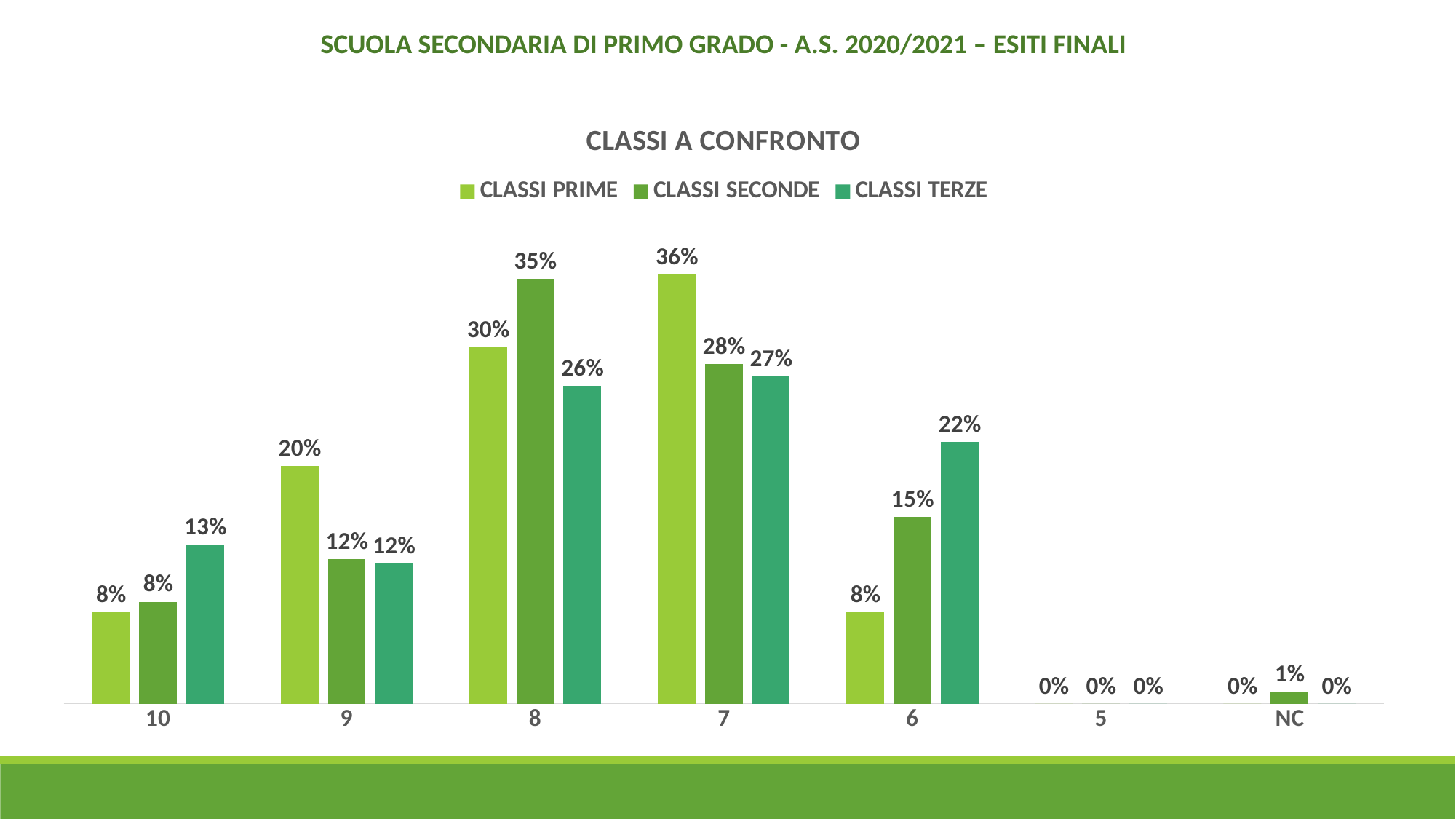
What kind of chart is shown? Bar chart What is the value for CLASSI TERZE at category 6? 22% Which is larger at category 10: CLASSI TERZE or CLASSI PRIME? CLASSI TERZE What is the value for CLASSI SECONDE at category 8? 35% What is the difference between CLASSI TERZE and CLASSI PRIME at category 6? 14% Which category has the highest value for CLASSI SECONDE? 8 What is the value for CLASSI PRIME at category 7? 36% Which category has the highest value for CLASSI PRIME? 7 What is the title of the chart? CLASSI A CONFRONTO What is the difference between CLASSI PRIME and CLASSI TERZE at category 9? 8% How many categories are shown on the x axis? 7 How many series does the legend list? 3